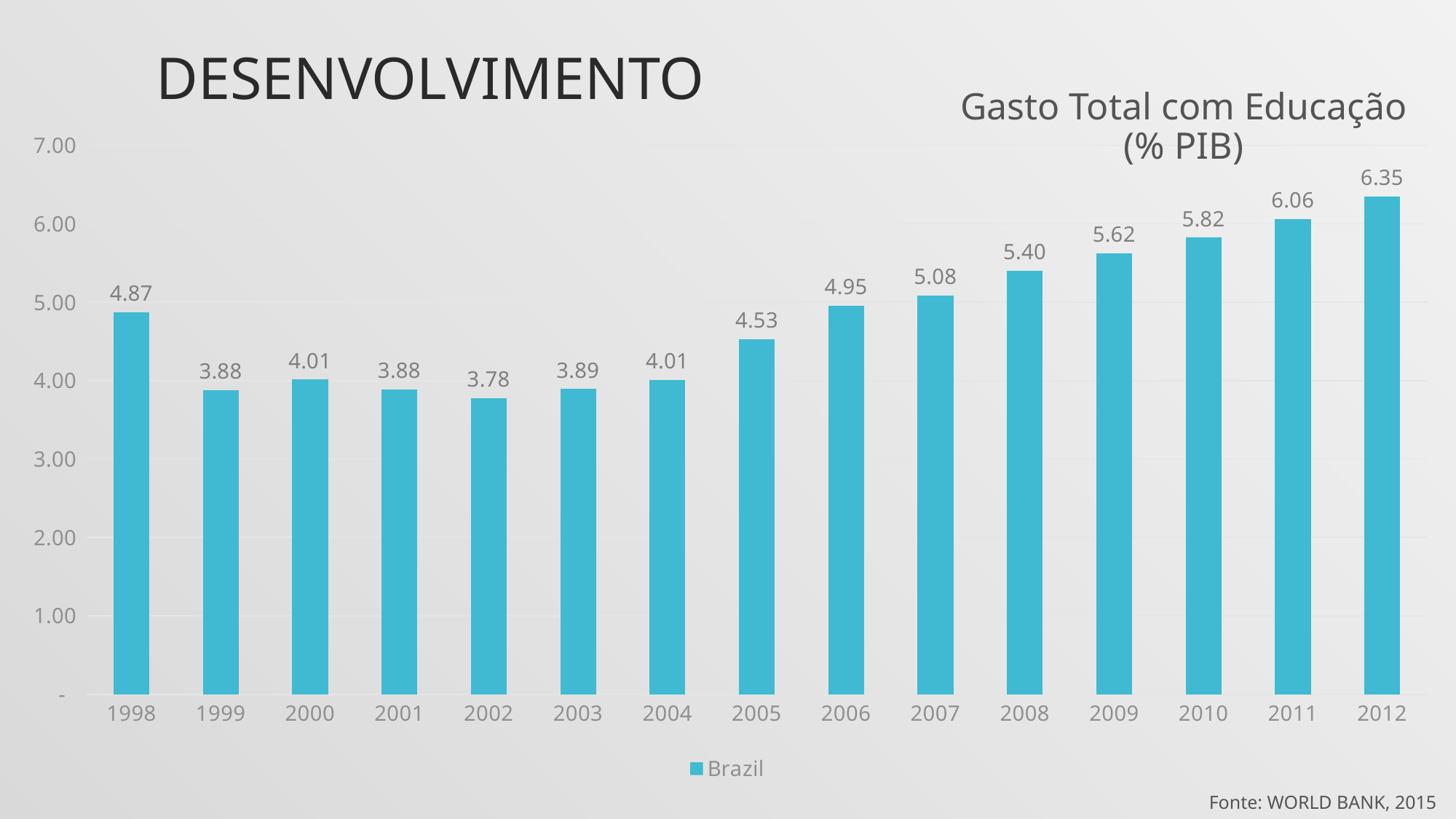
How many years are shown on the x axis? 15 Which year has the highest value? 2012 Which is larger, the value for 1998 or the value for 2006? 2006 What is the difference between the values for 2012 and 2011? 0.29 How many series does the legend list? 1 What is the value for 2012? 6.35 What is the value for 2005? 4.53 Is the value for 2010 greater or less than 6.00? less What kind of chart is shown? bar chart What is the title of the chart? Gasto Total com Educação (% PIB) Which year has the lowest value? 2002 What is the value for 1998? 4.87